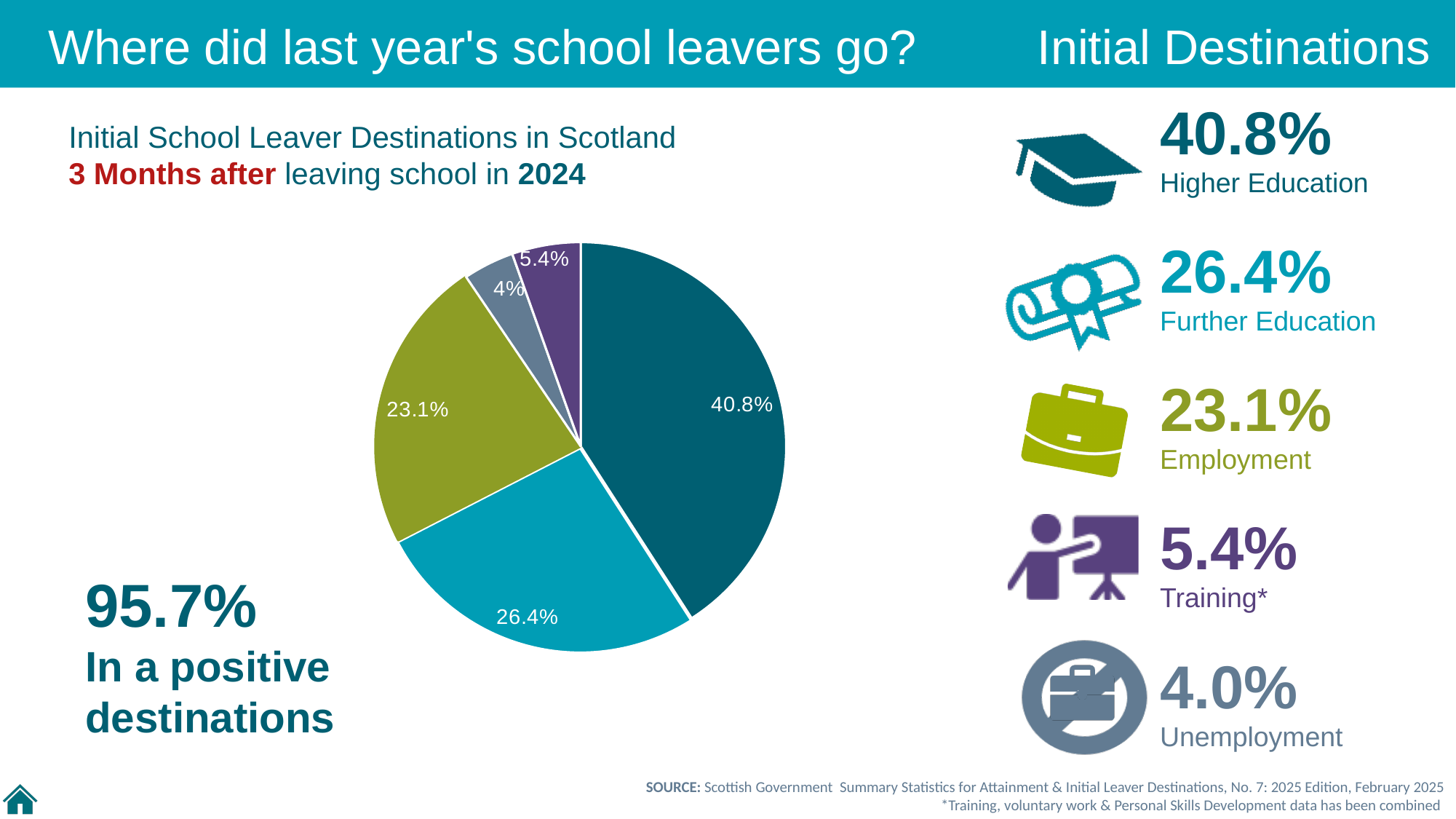
Which destination has the largest slice of the pie chart? Higher Education What colour is the Employment slice of the pie chart? olive green Which destination has the smallest slice of the pie chart? Unemployment What is the difference in percentage points between the Further Education and Employment slices? 3.3 How many slices does the pie chart have? 5 What share of school leavers went into Employment? 23.1% What share of school leavers went into Higher Education according to the pie chart? 40.8% What is the difference in percentage points between the Higher Education and Further Education slices? 14.4 Which slice is larger, Employment or Training? Employment What kind of chart is shown on the slide? pie chart What share of school leavers went into Training? 5.4% What share of school leavers went into Further Education? 26.4%